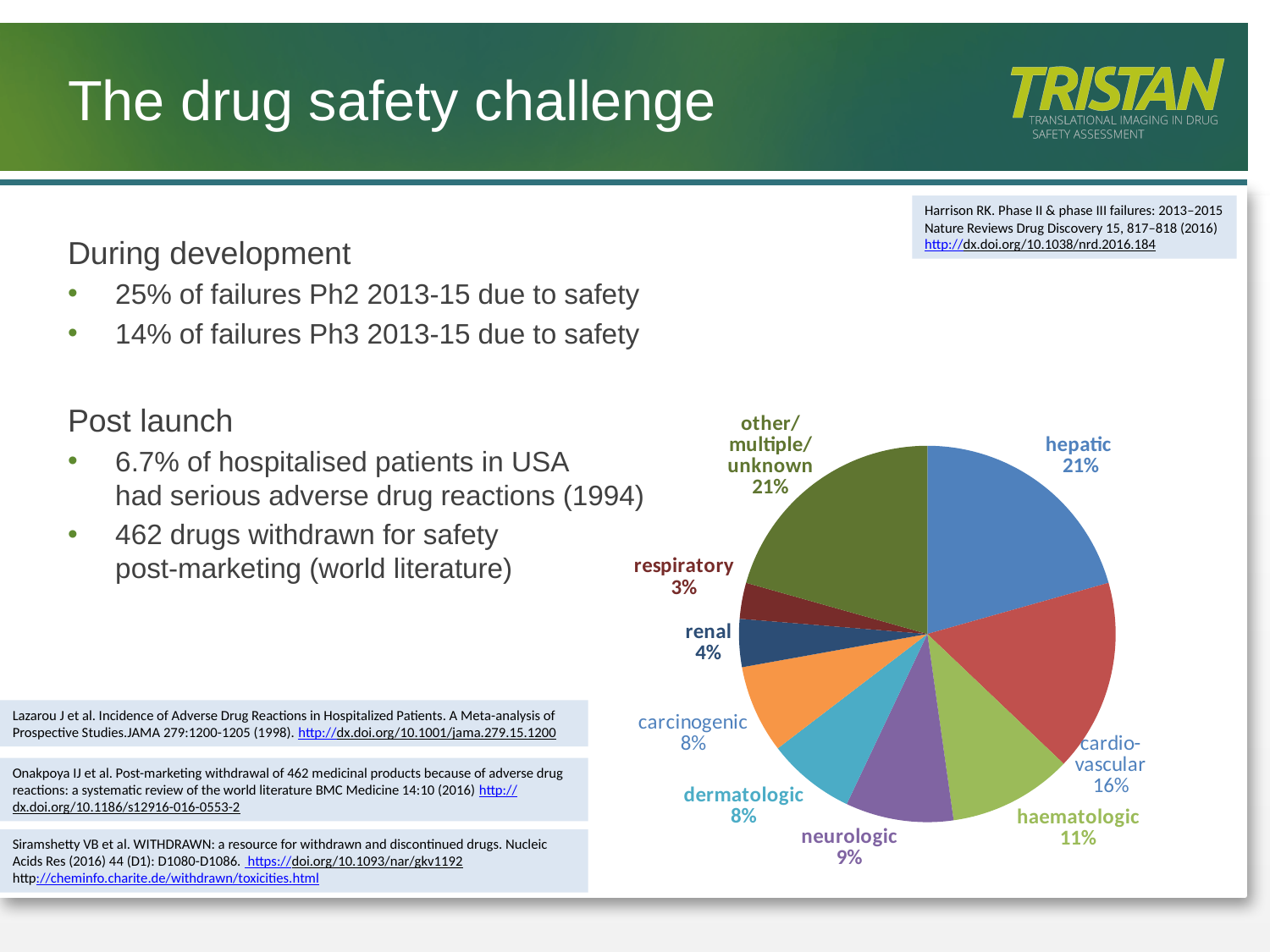
What percentage of the pie chart is labelled hepatic? 21% Which slice of the pie chart is the smallest? respiratory What is the label of the slice that shares the same 21% value as hepatic? other/multiple/unknown What is the combined share of the dermatologic and carcinogenic slices? 16% How many slices does the pie chart have? 9 What percentage is shown for the renal slice? 4% What percentage is shown for the haematologic slice? 11% Which is larger in the pie chart, cardiovascular or haematologic? cardiovascular What is the difference in percentage points between the hepatic slice and the cardiovascular slice? 5 What share does the cardiovascular slice have in the pie chart? 16% What kind of chart is shown on the slide? pie chart What value is printed for the neurologic slice of the pie chart? 9%